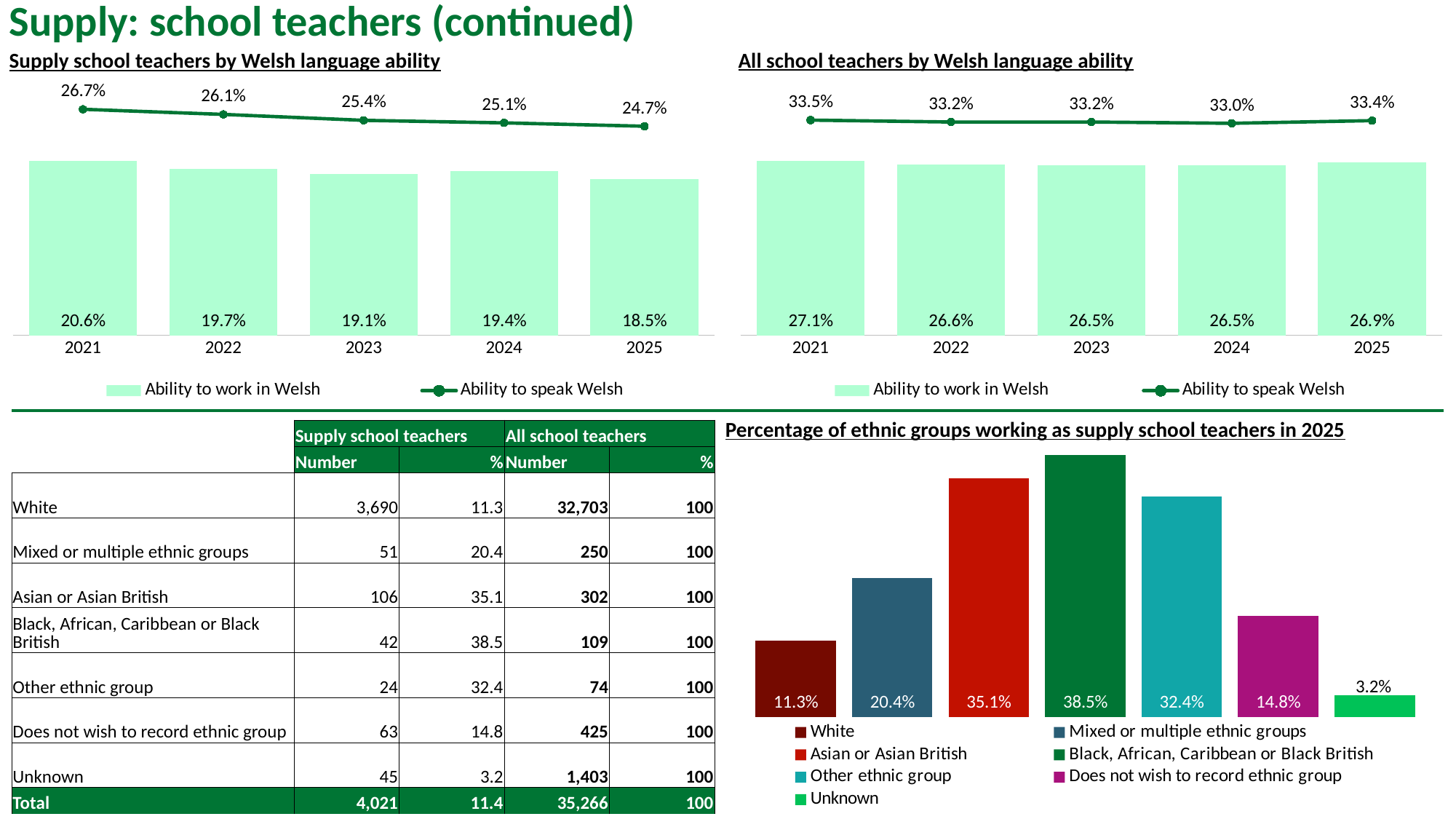
In the 'Supply school teachers by Welsh language ability' chart, what is the difference between the 'Ability to speak Welsh' and 'Ability to work in Welsh' values for 2023? 6.3% In the 'All school teachers by Welsh language ability' chart, which year has the highest 'Ability to speak Welsh' value? 2021 In the 'Percentage of ethnic groups working as supply school teachers in 2025' chart, how many ethnic groups are plotted? 7 In the 'Supply school teachers by Welsh language ability' chart, what is the 'Ability to work in Welsh' value for 2025? 18.5% In the 'Supply school teachers by Welsh language ability' chart, does the 'Ability to speak Welsh' line rise or fall from 2021 to 2025? fall In the 'Percentage of ethnic groups working as supply school teachers in 2025' chart, what is the value for 'Other ethnic group'? 32.4% In the 'All school teachers by Welsh language ability' chart, which year has the lowest 'Ability to work in Welsh' value? 2023 and 2024 (tied at 26.5%) How many series does the legend of the 'All school teachers by Welsh language ability' chart list? 2 In the 'Percentage of ethnic groups working as supply school teachers in 2025' chart, which ethnic group has the highest value? Black, African, Caribbean or Black British What kind of chart is the 'Percentage of ethnic groups working as supply school teachers in 2025' chart? bar chart In the 'All school teachers by Welsh language ability' chart, what is the 'Ability to work in Welsh' value for 2025? 26.9% In the 'Supply school teachers by Welsh language ability' chart, what is the 'Ability to speak Welsh' value for 2021? 26.7%